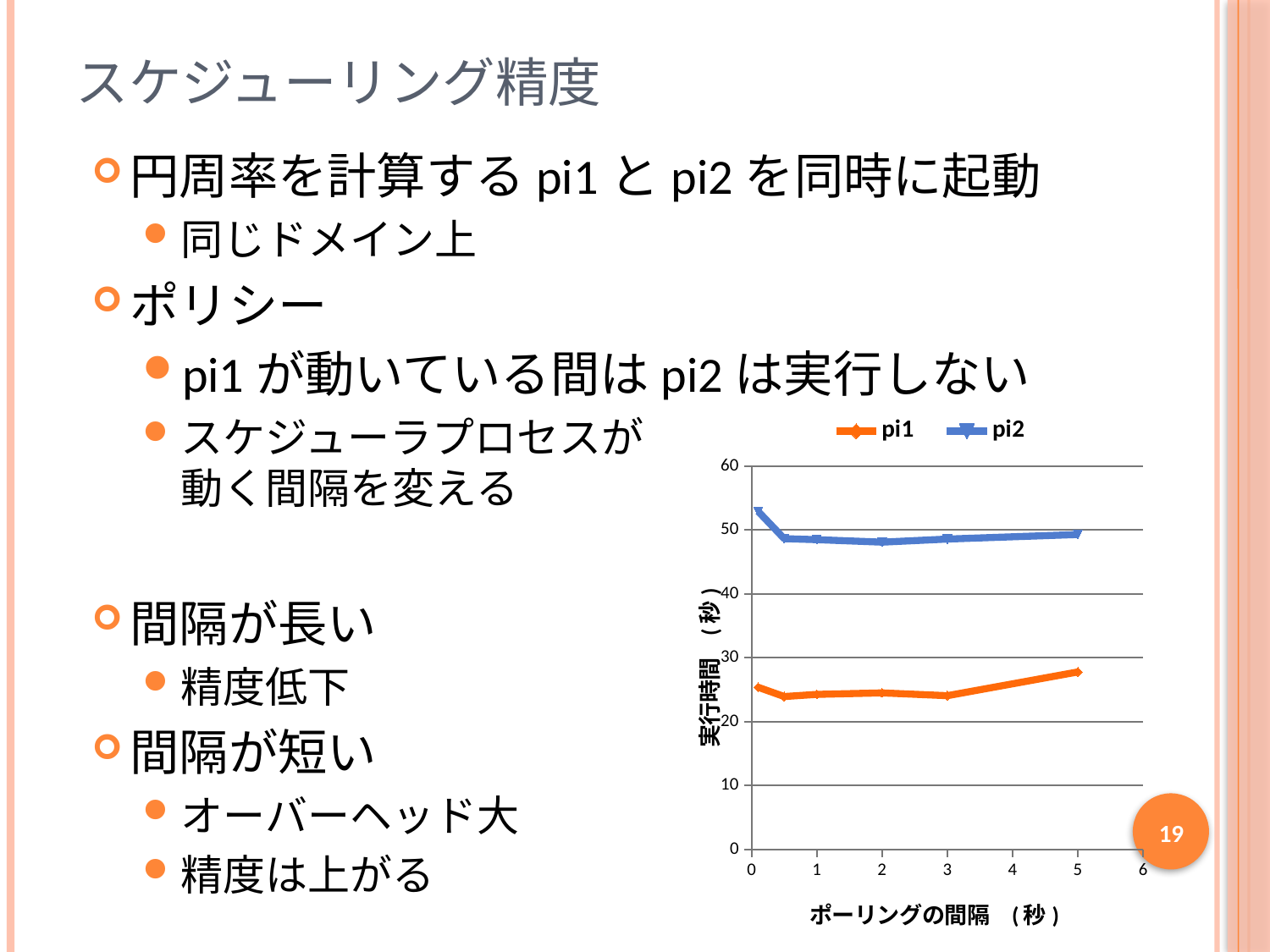
Is the value for pi2 at a polling interval of 3 seconds greater or less than 40? greater Which series has the lower execution time at a polling interval of 1 second, pi1 or pi2? pi1 What is the title of the chart's x axis? ポーリングの間隔 （秒） Which series has the higher execution time at a polling interval of 3 seconds, pi1 or pi2? pi2 What are the names of the two series in the chart's legend? pi1 and pi2 Is the value for pi2 at a polling interval of 2 seconds greater or less than 50? less Is the first plotted value for pi2 (near a polling interval of 0 seconds) greater or less than 50? greater How many series does the chart's legend list? 2 What kind of chart is shown on the slide? line chart Does the pi1 line rise or fall between polling intervals of 3 and 5 seconds? rise